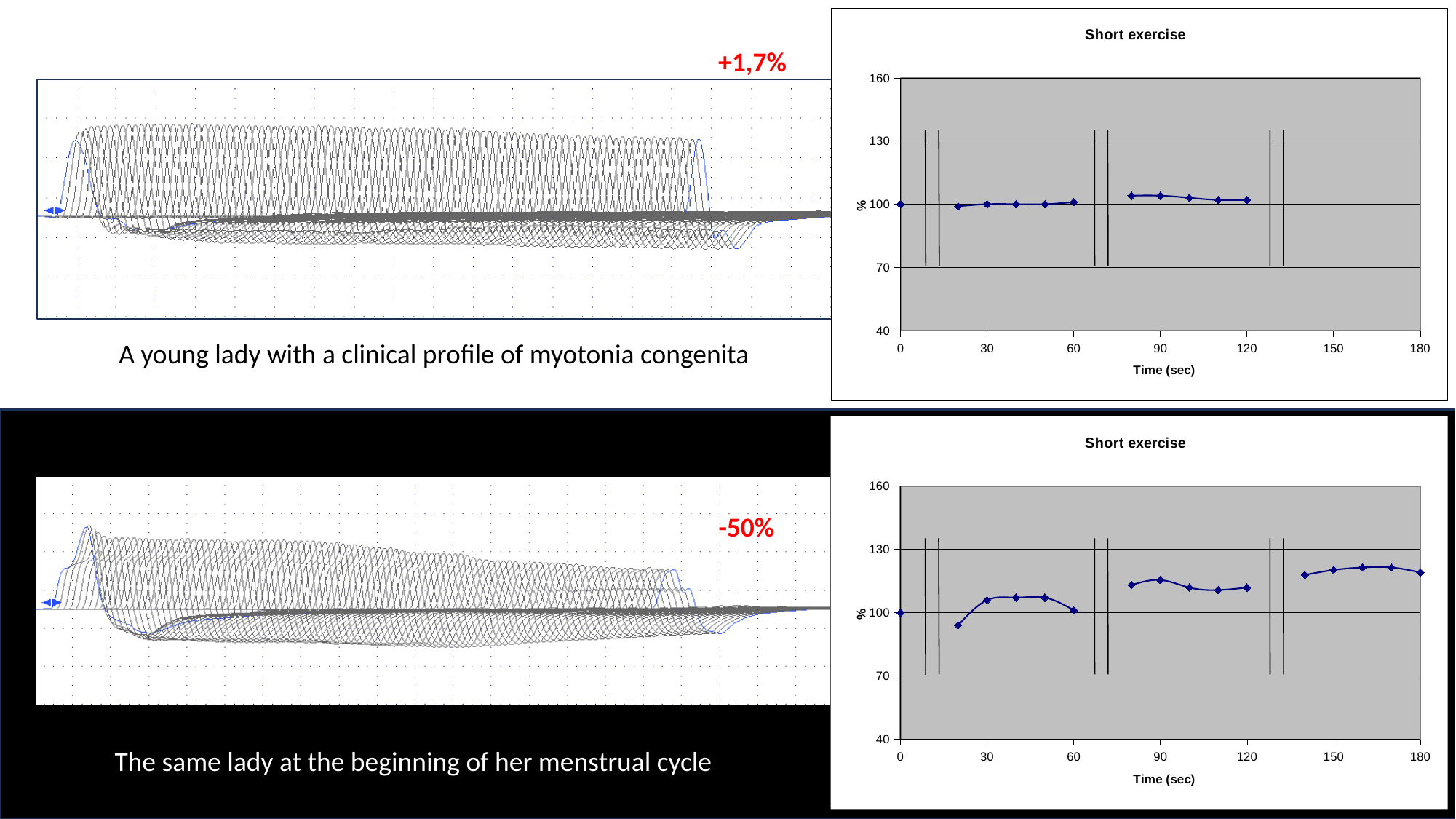
In the bottom-right 'Short exercise' chart, which time point has the lowest value? 20 In the bottom-right 'Short exercise' chart, do the values rise or fall between 20 sec and 40 sec? rise In the bottom-right 'Short exercise' chart, which is larger: the value at 160 sec or the value at 60 sec? 160 sec How many data points are plotted in the bottom-right 'Short exercise' chart? 16 What is the title of the bottom-right chart? Short exercise In the top-right 'Short exercise' chart, is the value at 90 sec greater or less than 130? less What is the x-axis label of the top-right 'Short exercise' chart? Time (sec) What type of chart is the top-right 'Short exercise' chart? line chart In the bottom-right 'Short exercise' chart, is the value at 20 sec greater or less than 100? less In the bottom-right 'Short exercise' chart, is the value at 180 sec greater or less than 100? greater How many data points are plotted in the top-right 'Short exercise' chart? 11